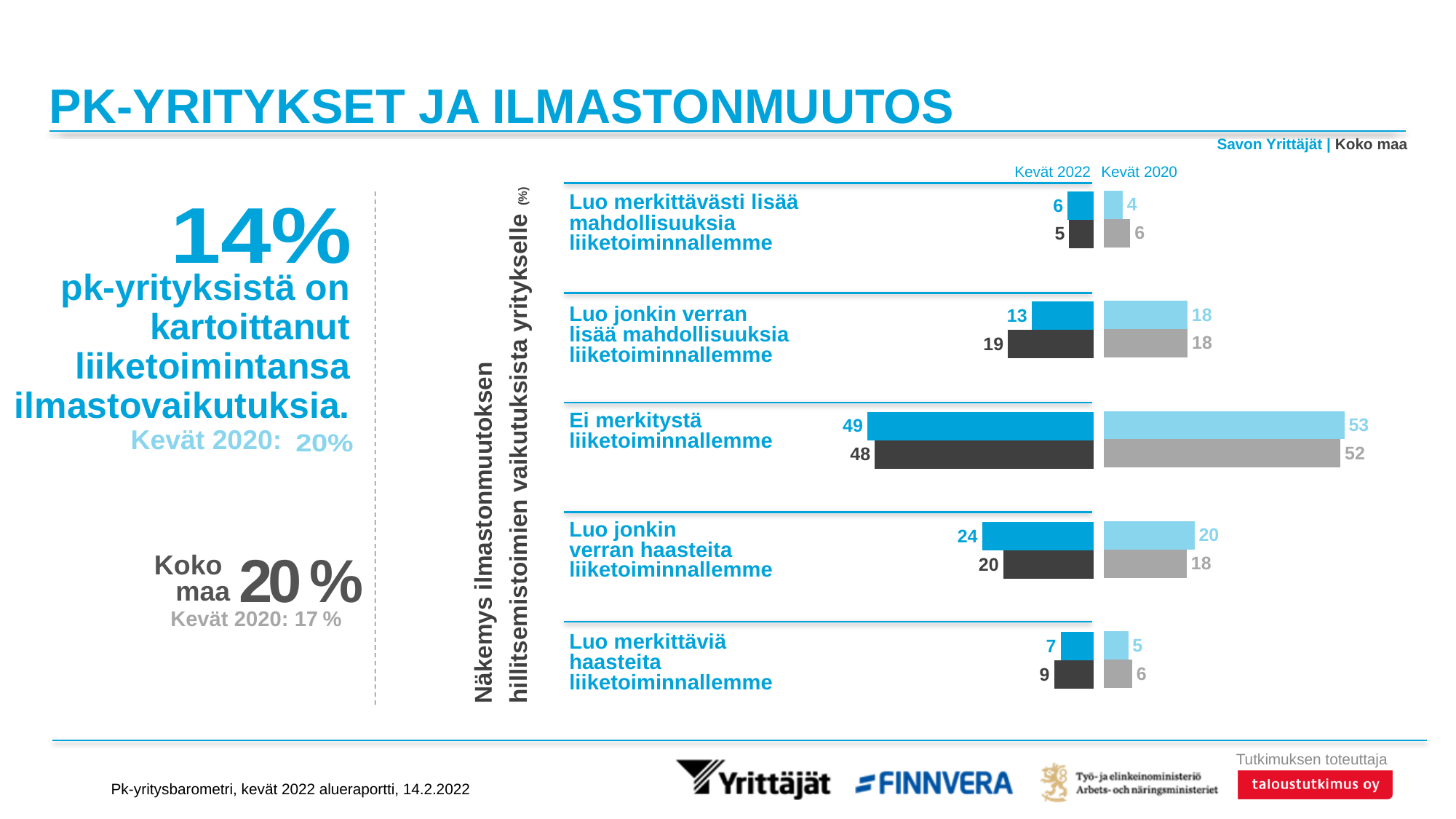
For "Luo jonkin verran haasteita liiketoiminnallemme", which is larger: the Savon Yrittäjät Kevät 2022 value or the Koko maa Kevät 2022 value? Savon Yrittäjät Kevät 2022 Which category has the highest Savon Yrittäjät Kevät 2022 value? Ei merkitystä liiketoiminnallemme Which category has the lowest Koko maa Kevät 2022 value? Luo merkittävästi lisää mahdollisuuksia liiketoiminnallemme What is the difference between the Savon Yrittäjät Kevät 2022 and Koko maa Kevät 2022 values for "Luo jonkin verran lisää mahdollisuuksia liiketoiminnallemme"? 6 What kind of chart is shown on the slide? Bar chart What is the difference between the Savon Yrittäjät Kevät 2020 and Koko maa Kevät 2020 values for "Ei merkitystä liiketoiminnallemme"? 1 What is the Koko maa Kevät 2020 value for "Luo merkittäviä haasteita liiketoiminnallemme"? 6 What is the Savon Yrittäjät Kevät 2020 value for "Luo jonkin verran haasteita liiketoiminnallemme"? 20 What is the Savon Yrittäjät Kevät 2022 value for "Ei merkitystä liiketoiminnallemme"? 49 How many categories does the chart show? 5 What is the Koko maa Kevät 2022 value for "Luo jonkin verran lisää mahdollisuuksia liiketoiminnallemme"? 19 Which two survey periods does the chart compare? Kevät 2022 and Kevät 2020